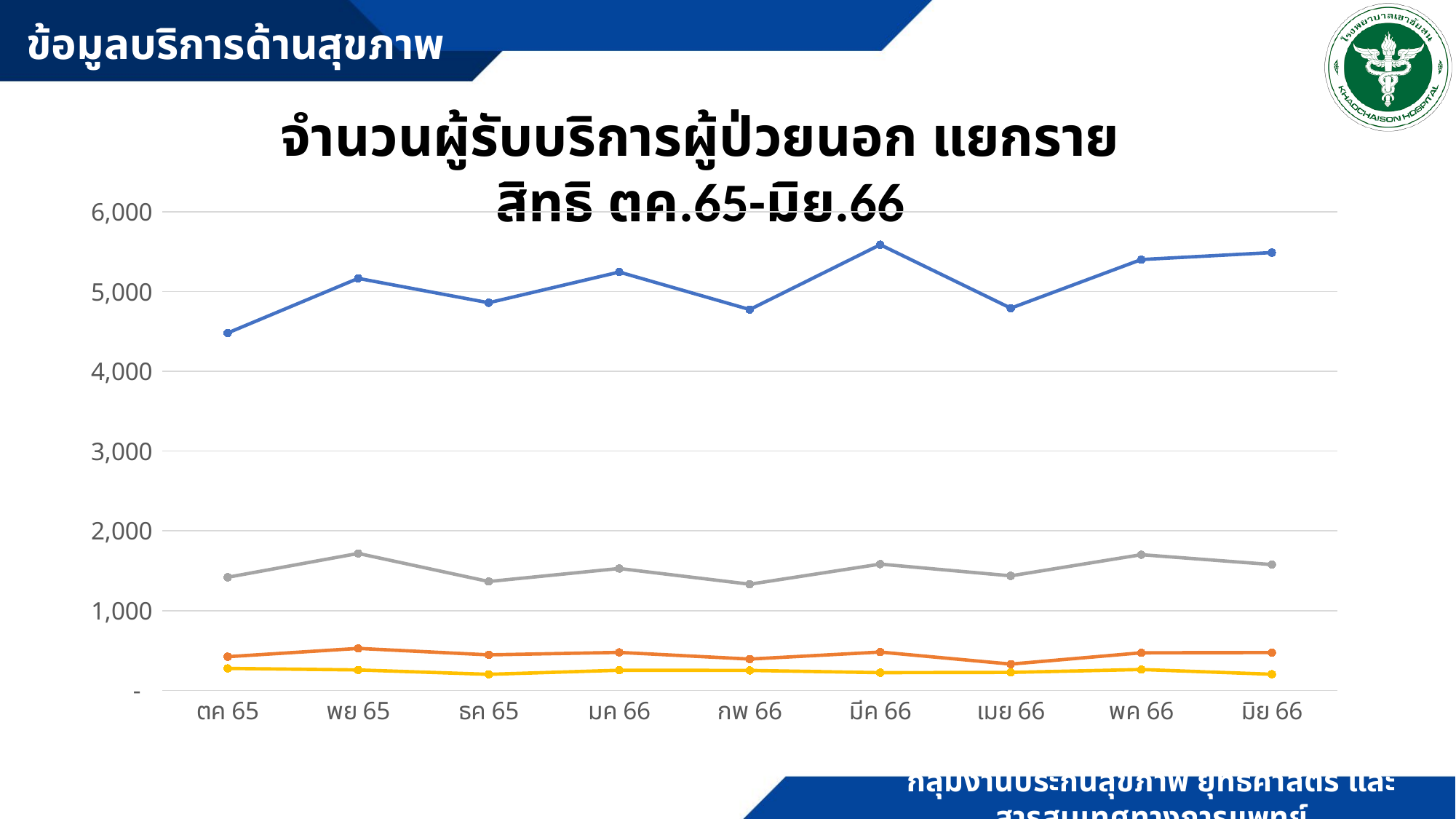
Is the value of the blue line at ธค 65 greater or less than 5,000? less At ตค 65, which line has the larger value, the orange line or the yellow line? orange line Is the value of the gray line at ตค 65 greater or less than 1,000? greater Is the value of the orange line at มีค 66 greater or less than 1,000? less What is the title of the chart? จำนวนผู้รับบริการผู้ป่วยนอก แยกรายสิทธิ ตค.65-มิย.66 What kind of chart is shown on the slide? line chart How many lines are plotted on the chart? 4 How many months are shown along the x axis of the chart? 9 At which month does the blue line reach its lowest value? ตค 65